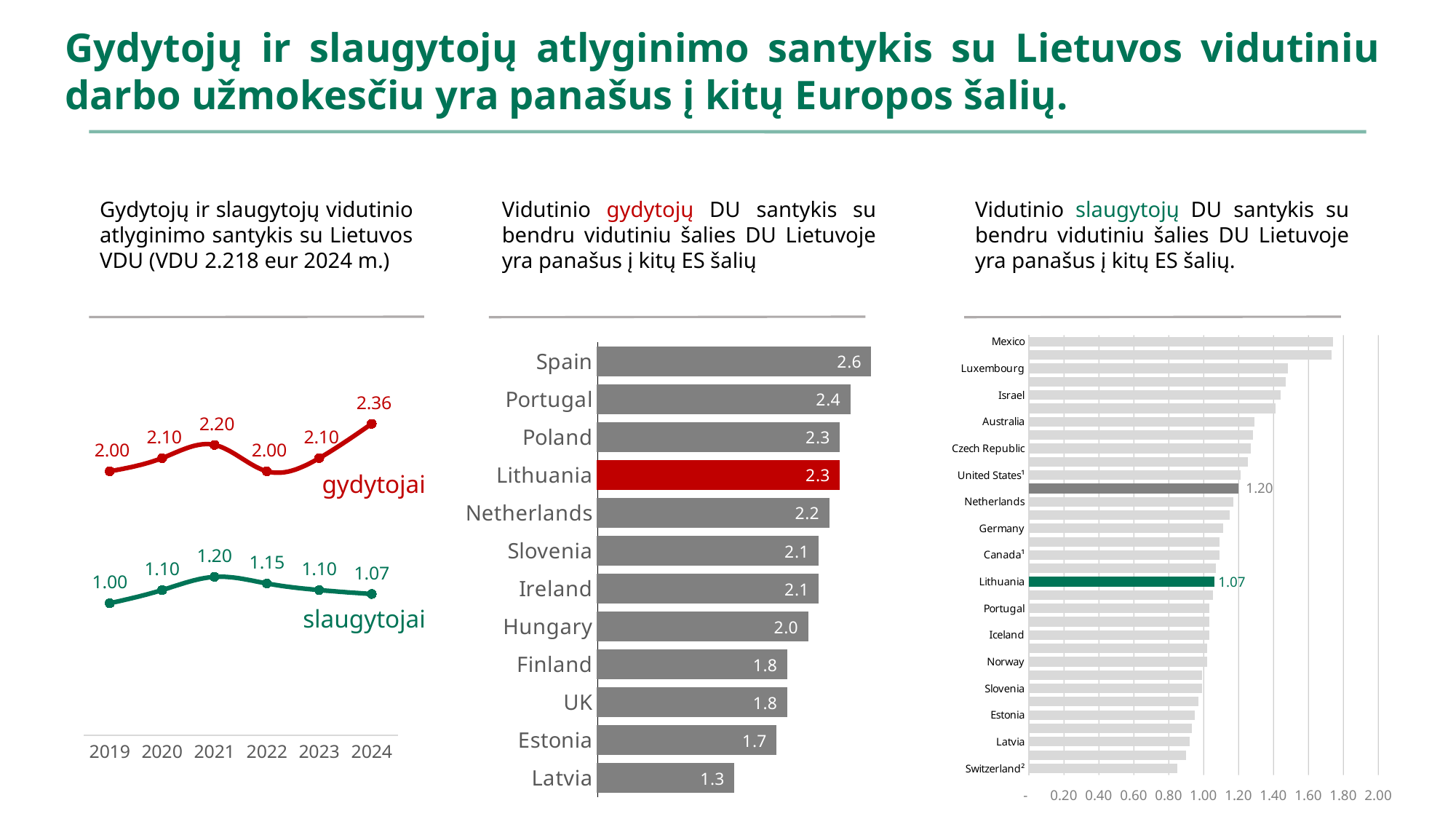
In the left line chart, what is the value for slaugytojai in 2021? 1.20 In the middle bar chart, which country has the highest value? Spain In the left line chart, what is the value for gydytojai in 2024? 2.36 In the left line chart, how many years are shown on the x axis? 6 What kind of chart is the left chart? line chart In the middle bar chart, what is the difference between the values for Spain and Latvia? 1.3 In the right bar chart, what is the value for Lithuania? 1.07 In the left line chart, do the slaugytojai values rise or fall from 2021 to 2024? fall In the left line chart, what is the difference between the gydytojai and slaugytojai values in 2024? 1.29 In the middle bar chart, which country has the lowest value? Latvia In the middle bar chart, what is the value for Lithuania? 2.3 In the middle bar chart, which is larger, the value for Portugal or the value for Netherlands? Portugal